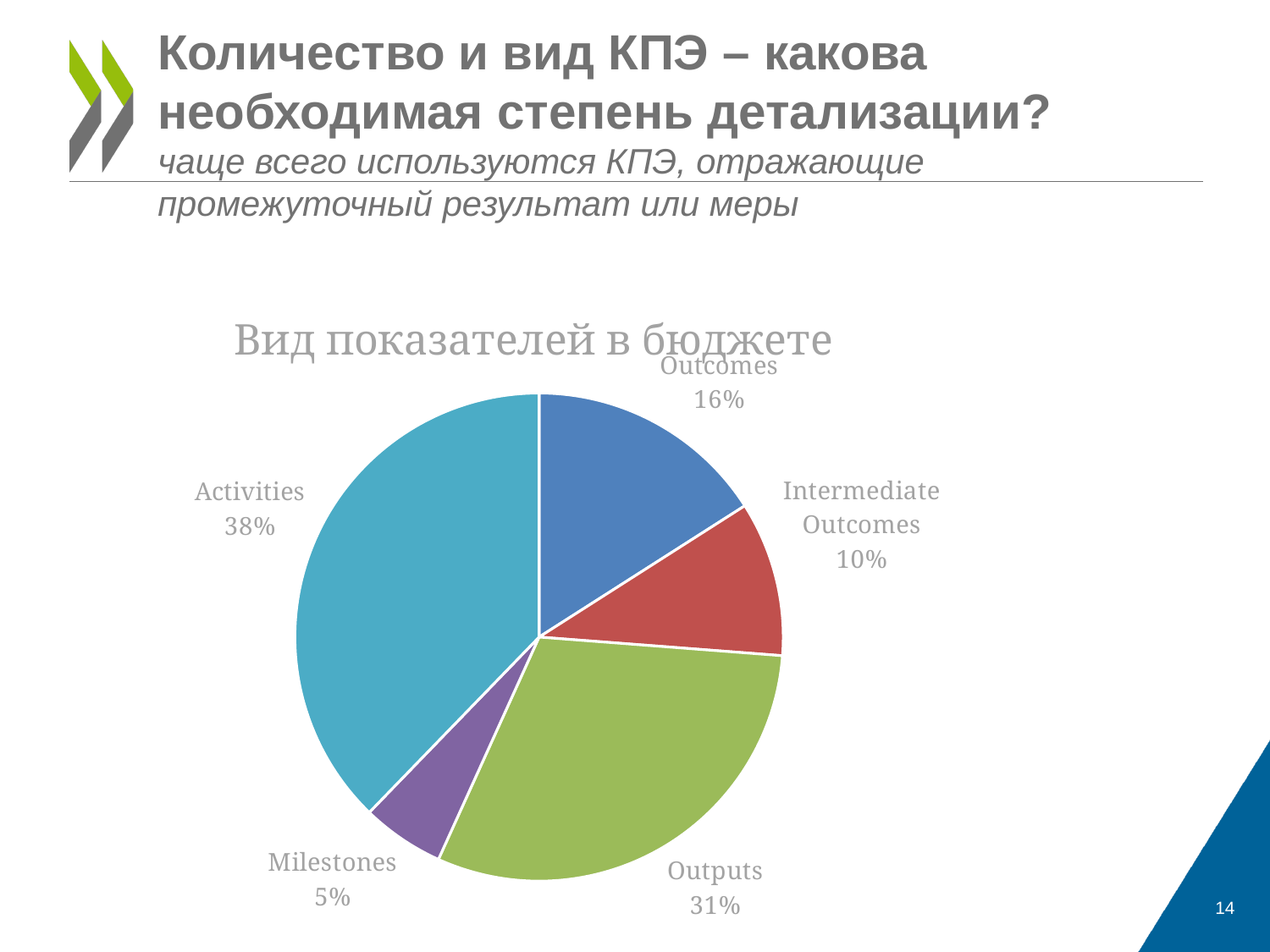
What share of the pie is Milestones? 5% What type of chart is shown on the slide? pie chart Which category has the largest share of the pie? Activities Which is larger, the share of Outcomes or the share of Intermediate Outcomes? Outcomes What is the title of the chart? Вид показателей в бюджете What is the difference between the shares of Activities and Outputs? 7% Which category has the smallest share of the pie? Milestones What share of the pie is Intermediate Outcomes? 10% What share of the pie is Outcomes? 16% How many categories are shown in the pie chart? 5